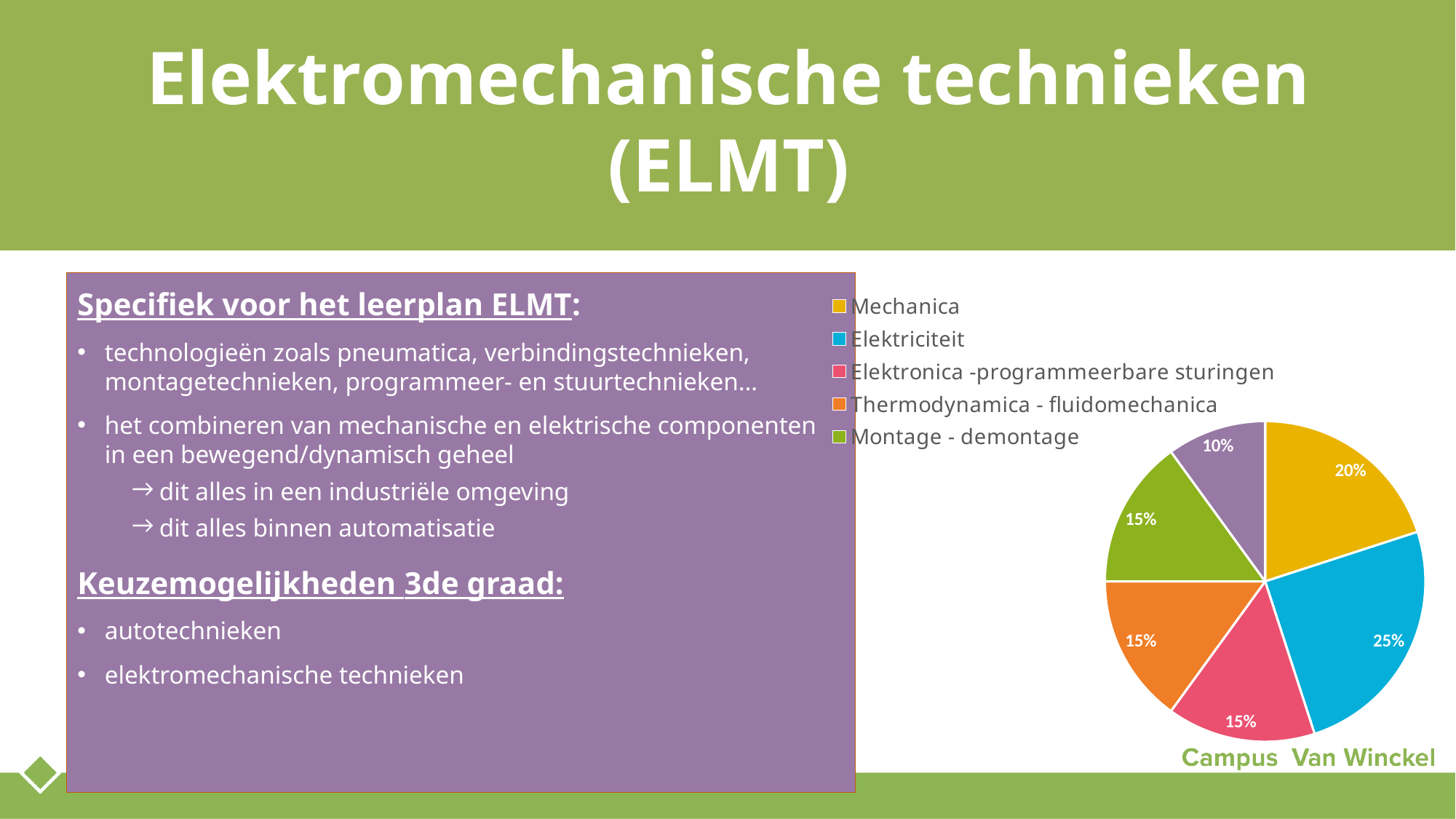
How many slices does the pie chart have? 6 What percentage does the pie chart show for Elektriciteit? 25% What percentage does the pie chart show for Mechanica? 20% What percentage does the pie chart show for Thermodynamica - fluidomechanica? 15% What is the difference in percentage points between the Elektriciteit slice and the Mechanica slice? 5% What type of chart is shown on the slide? Pie chart Which legend category has the largest slice in the pie chart? Elektriciteit What percentage does the pie chart show for Elektronica -programmeerbare sturingen? 15% What percentage does the pie chart show for Montage - demontage? 15% What is the smallest percentage shown on any slice of the pie chart? 10% Which is larger in the pie chart, Mechanica or Elektriciteit? Elektriciteit How many entries does the legend of the pie chart list? 5